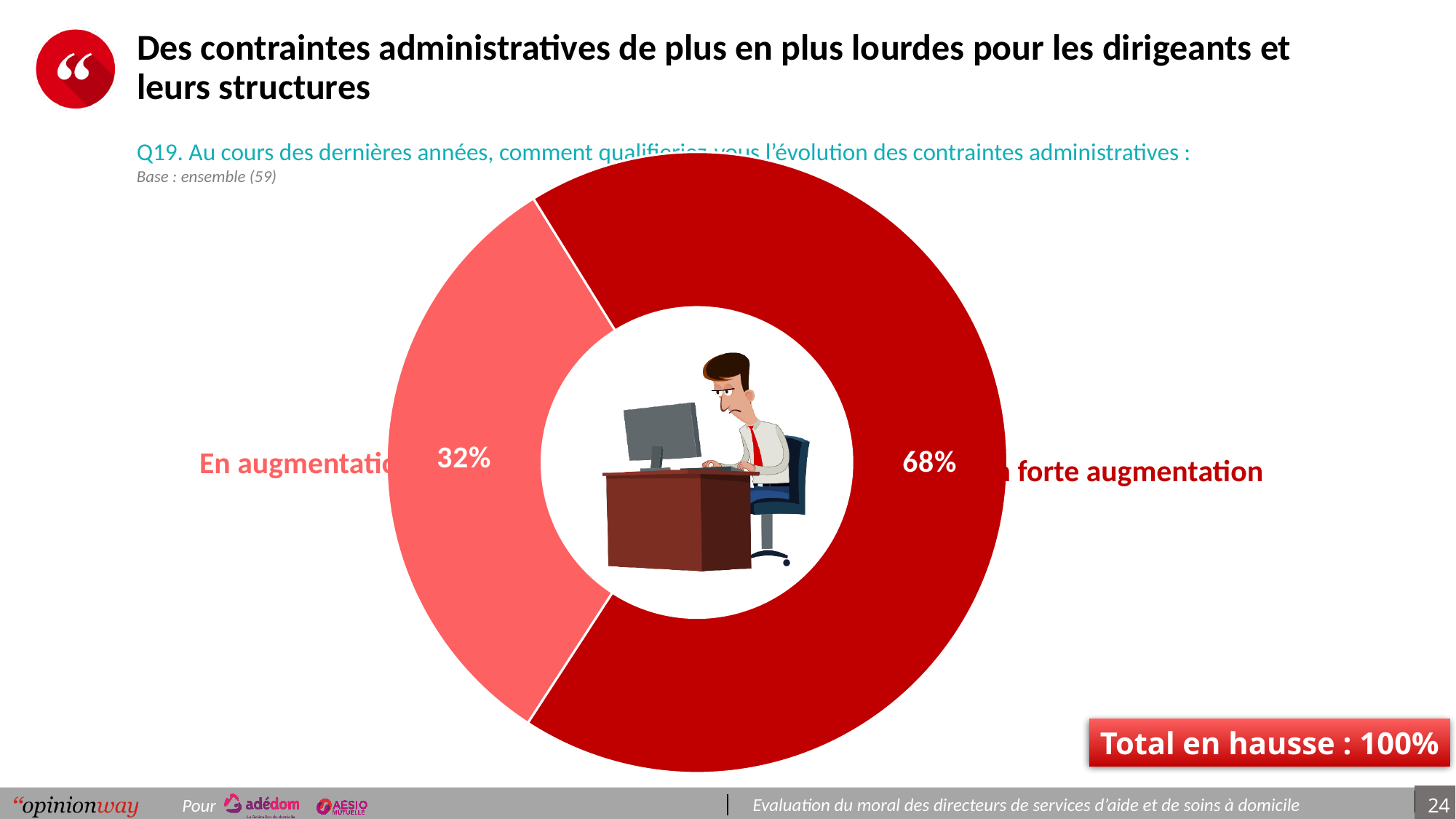
What percentage of respondents answered "En forte augmentation"? 68% Which response has the largest share of the pie? En forte augmentation What is the difference in percentage points between "En forte augmentation" and "En augmentation"? 36 Is the share for "En forte augmentation" greater or less than 50%? greater How many slices does the pie chart have? 2 What kind of chart is shown on the slide? Pie chart (donut) What colour is the slice for "En forte augmentation"? Dark red What is the combined total of the two slices, as stated on the slide? 100% What is the base (number of respondents) indicated for this question? 59 What percentage of respondents answered "En augmentation"? 32% Which response has the smallest share of the pie? En augmentation Which is larger: the share for "En augmentation" or the share for "En forte augmentation"? En forte augmentation